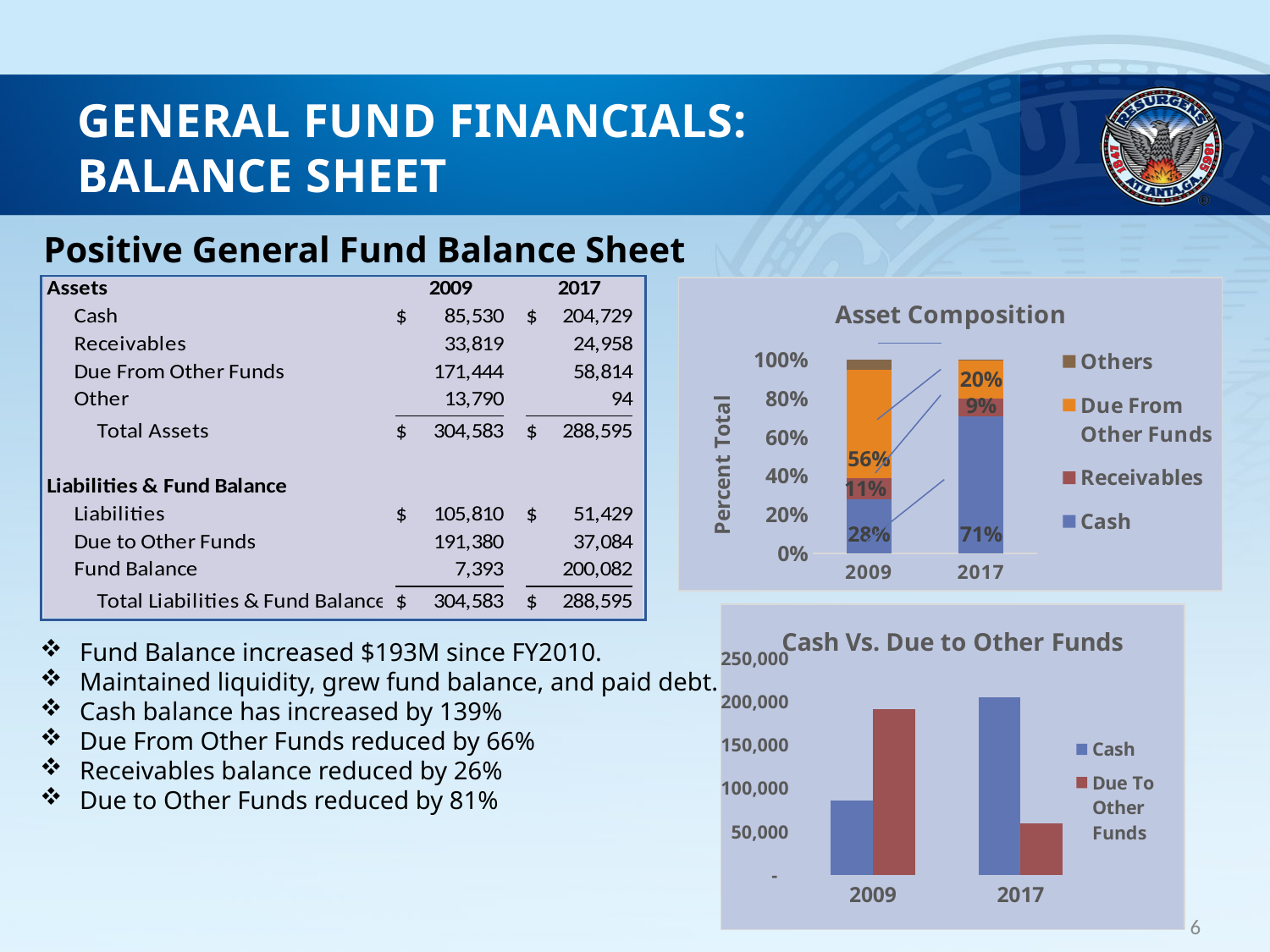
In the Asset Composition chart, what is the Cash share in 2009? 28% What type of chart is the Cash Vs. Due to Other Funds chart? Bar chart In the Asset Composition chart, by how many percentage points did the Cash share change from 2009 to 2017? 43 percentage points In the Asset Composition chart, what percentage does Due From Other Funds make up in 2009? 56% In the Cash Vs. Due to Other Funds chart, is the Cash value for 2009 greater or less than 100,000? less In the Asset Composition chart, what is the Receivables share in 2017? 9% How many years are shown on the x axis of the Cash Vs. Due to Other Funds chart? 2 In the Cash Vs. Due to Other Funds chart, is the Due To Other Funds value for 2017 greater or less than 50,000? greater In the Cash Vs. Due to Other Funds chart, which is larger in 2017: Cash or Due To Other Funds? Cash How many series does the legend of the Asset Composition chart list? 4 In the Asset Composition chart, what percentage does Cash make up of total assets in 2017? 71% In the Asset Composition chart, which is larger in 2009: the Cash share or the Due From Other Funds share? Due From Other Funds